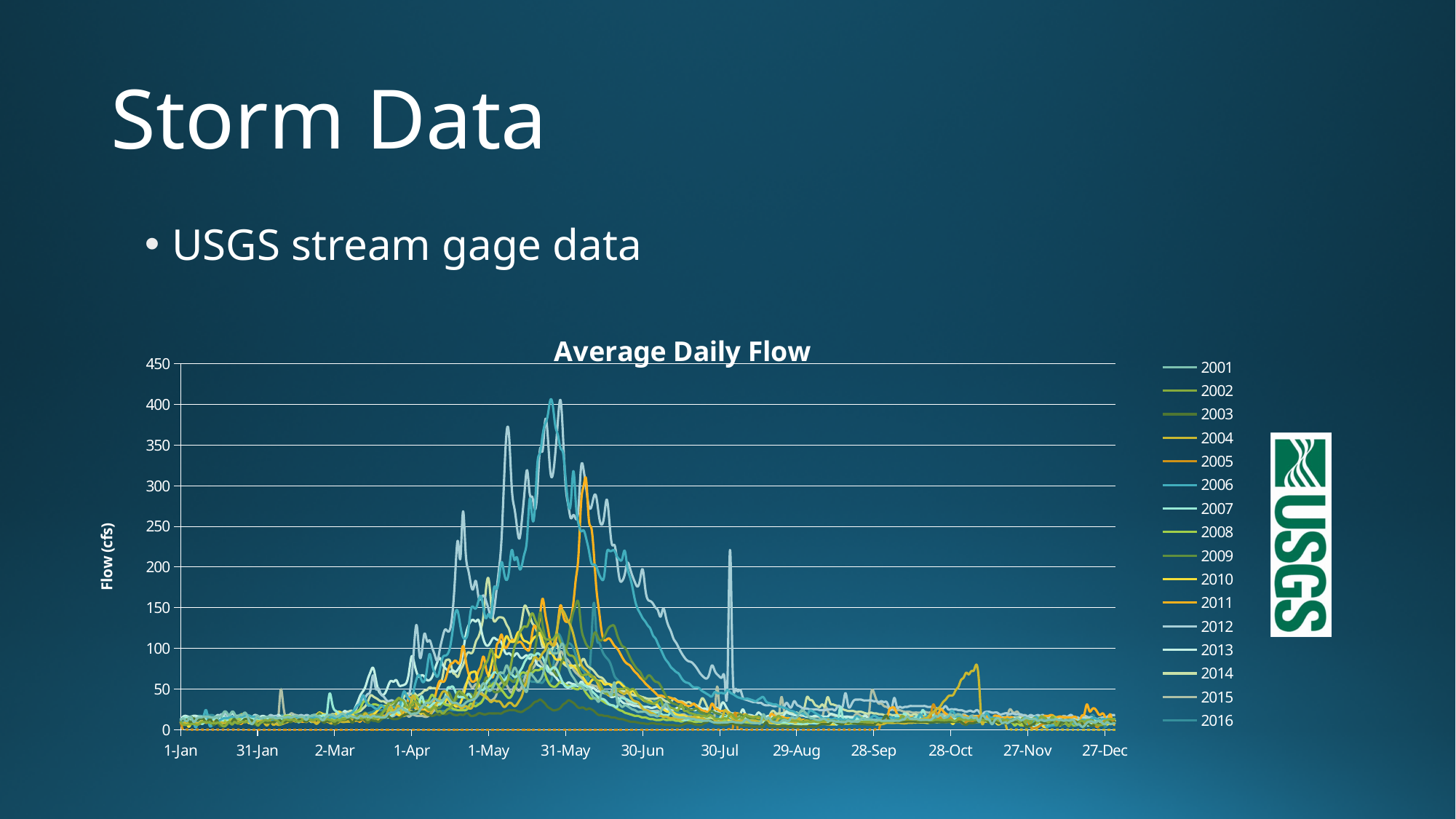
What is the title of the chart? Average Daily Flow Is the highest peak reached by any series greater or less than 350? greater Is the flow for all series on 1-Jan greater or less than 50? less What is the highest value shown on the vertical axis? 450 Do the flow values generally rise or fall between 1-Jan and 31-May? rise What is the first year listed in the legend? 2001 What kind of chart is shown on the slide? Line chart How many series does the chart's legend list? 16 Do the flow values generally rise or fall between 31-May and 29-Aug? fall